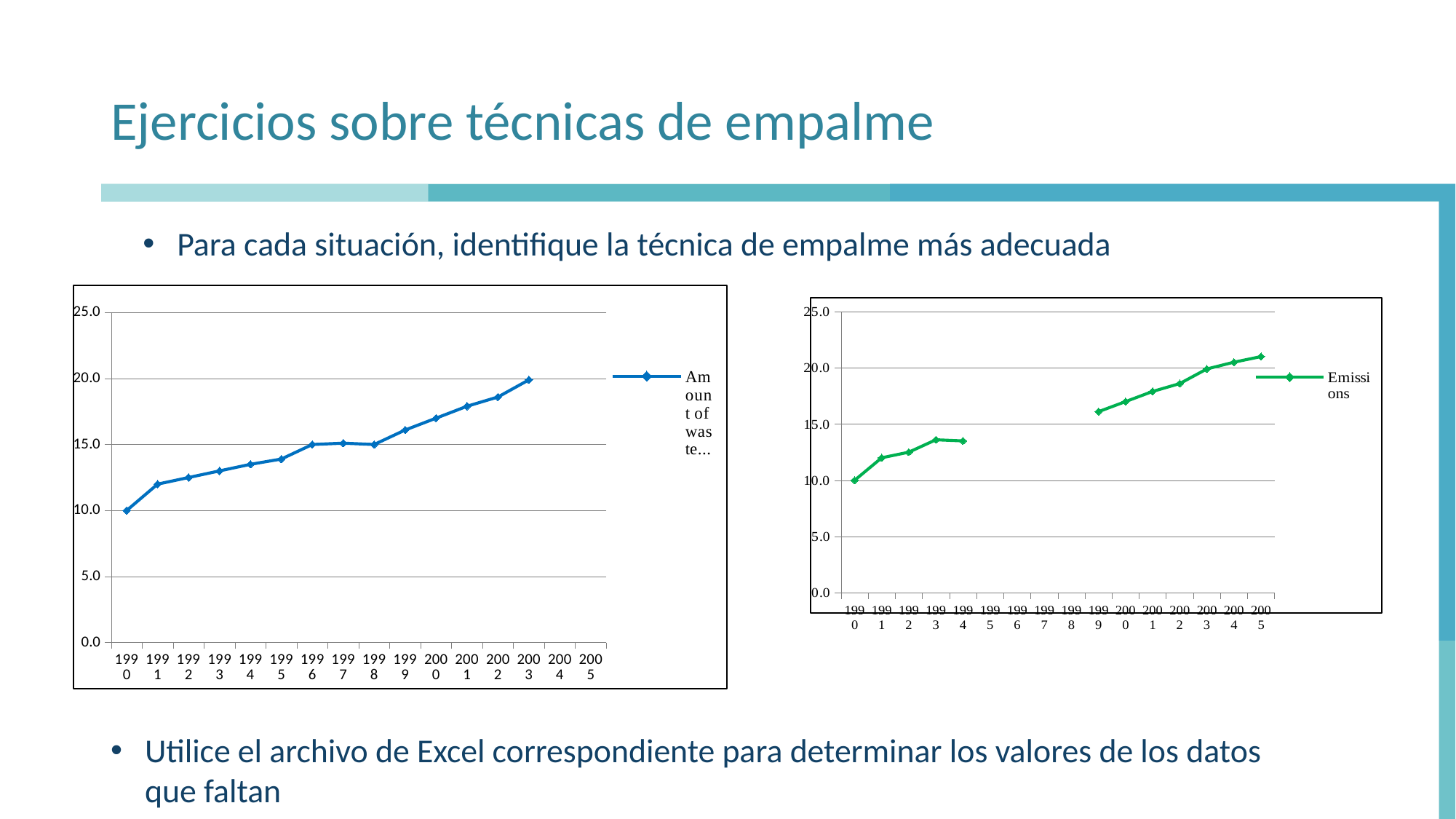
In the left chart (Amount of waste), is the value for 1990 greater or less than 15.0? less In the right chart (Emissions), which year has the highest plotted value? 2005 In the left chart (Amount of waste), how many years are shown on the x axis? 16 What kind of chart is the right chart (Emissions)? line chart In the right chart (Emissions), is the value for 2005 greater or less than 20.0? greater In the left chart (Amount of waste), how many series does the legend list? 1 In the left chart (Amount of waste), do the values rise or fall from 1990 to 2003? rise What kind of chart is the left chart (Amount of waste)? line chart In the right chart (Emissions), what is the name of the series shown in the legend? Emissions In the right chart (Emissions), is the value for 1994 greater or less than 15.0? less In the left chart (Amount of waste), which year has the lowest plotted value? 1990